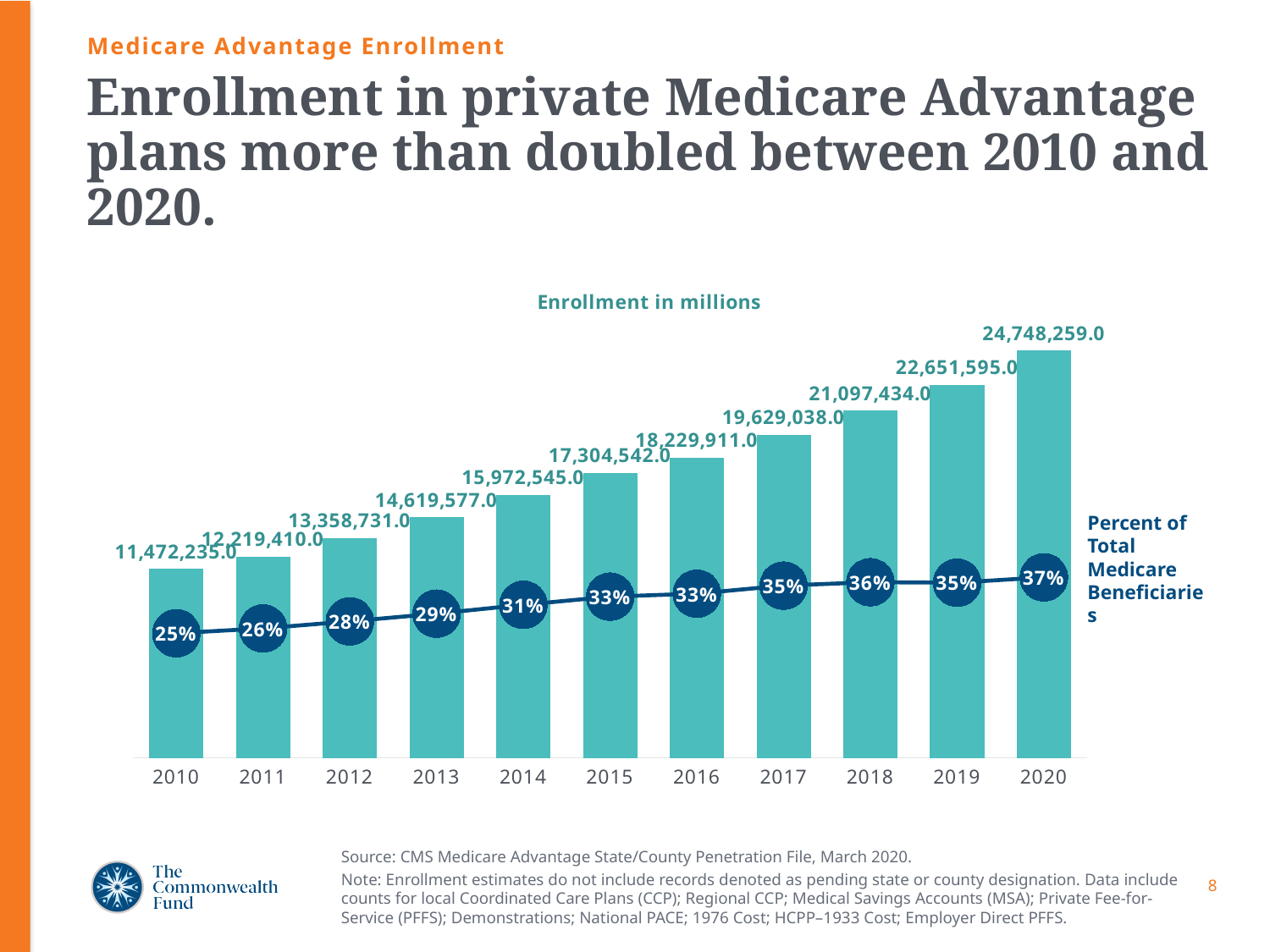
Which year has the lowest percent of total Medicare beneficiaries? 2010 Does enrollment rise or fall from 2010 to 2020? Rise What percent of total Medicare beneficiaries were enrolled in Medicare Advantage plans in 2015? 33% What is the enrollment value shown for 2016? 18,229,911.0 Which year has the highest enrollment? 2020 What kind of chart is used to show enrollment on this slide? Bar chart with a line overlay What is the Medicare Advantage enrollment shown for 2020? 24,748,259.0 What is the enrollment value shown for 2010? 11,472,235.0 How many years are shown on the x axis of the chart? 11 By how much did enrollment increase from 2010 to 2020? 13,276,024.0 What is the difference in percent of total Medicare beneficiaries between 2020 and 2010? 12 percentage points Which year has the higher percent of total Medicare beneficiaries, 2018 or 2019? 2018